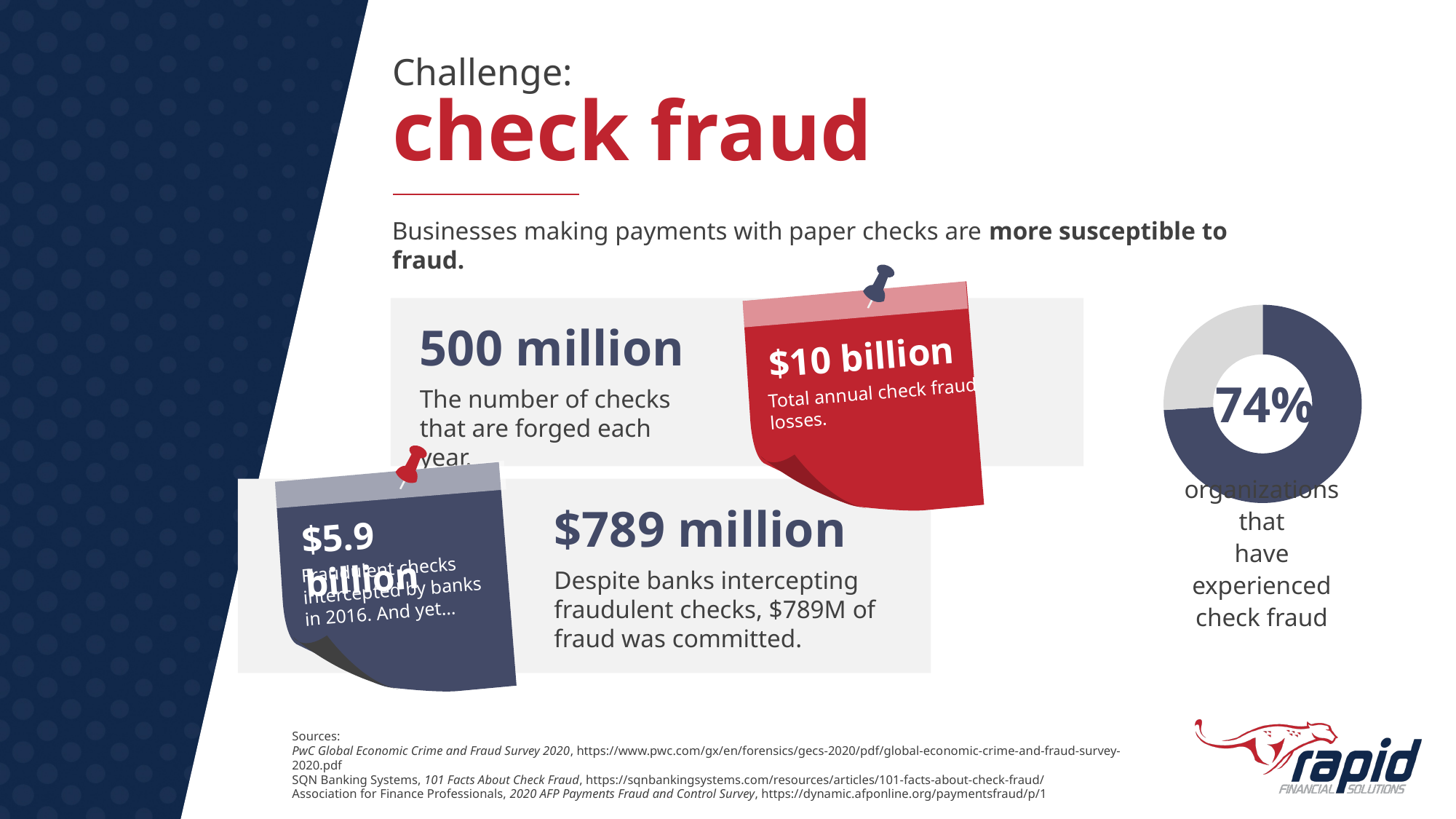
What share of the donut chart does the grey segment represent? 26% What percentage of organizations have experienced check fraud, according to the donut chart? 74% Is the value shown in the donut chart greater or less than 50%? greater What does the 74% in the donut chart represent? organizations that have experienced check fraud What colour is the segment representing the 74% in the donut chart? dark blue In the donut chart, which segment is larger: the dark blue one or the grey one? the dark blue one How many segments does the donut chart have? 2 Which segment of the donut chart is the largest? organizations that have experienced check fraud (74%) What kind of chart is shown on the right side of the slide? donut chart